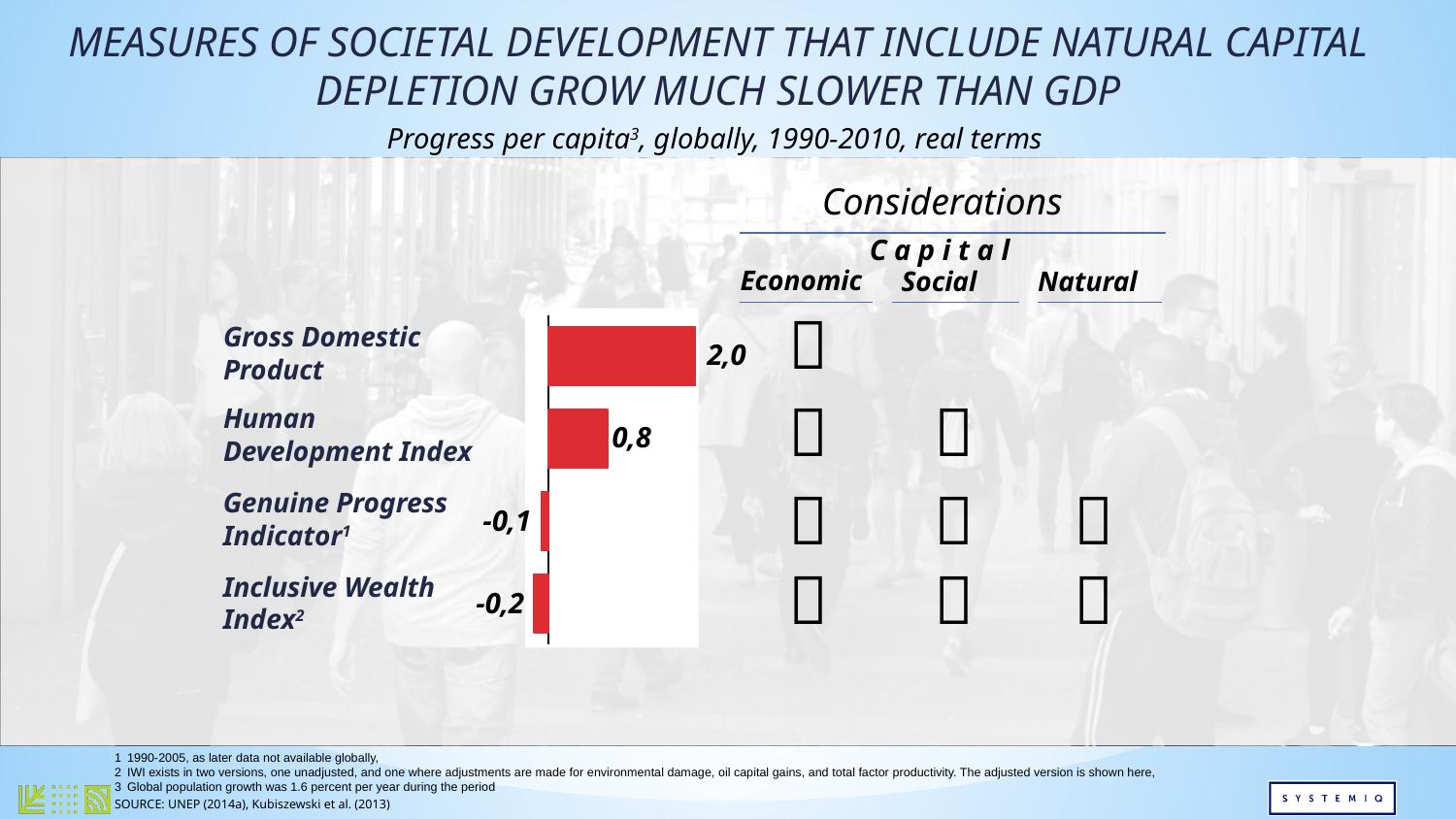
What is the value shown for Inclusive Wealth Index? -0,2 What is the difference between the values for Gross Domestic Product and Human Development Index? 1,2 How many of the plotted measures have negative values? 2 Which measure has the lowest value in the chart? Inclusive Wealth Index Which measure has the highest value in the chart? Gross Domestic Product What is the value shown for Genuine Progress Indicator? -0,1 What is the subtitle describing the data in the chart? Progress per capita, globally, 1990-2010, real terms What is the value shown for Human Development Index? 0,8 What kind of chart is shown on the slide? Bar chart How many measures are plotted in the bar chart? 4 Which is larger, the value for Human Development Index or the value for Genuine Progress Indicator? Human Development Index What is the value shown for Gross Domestic Product? 2,0